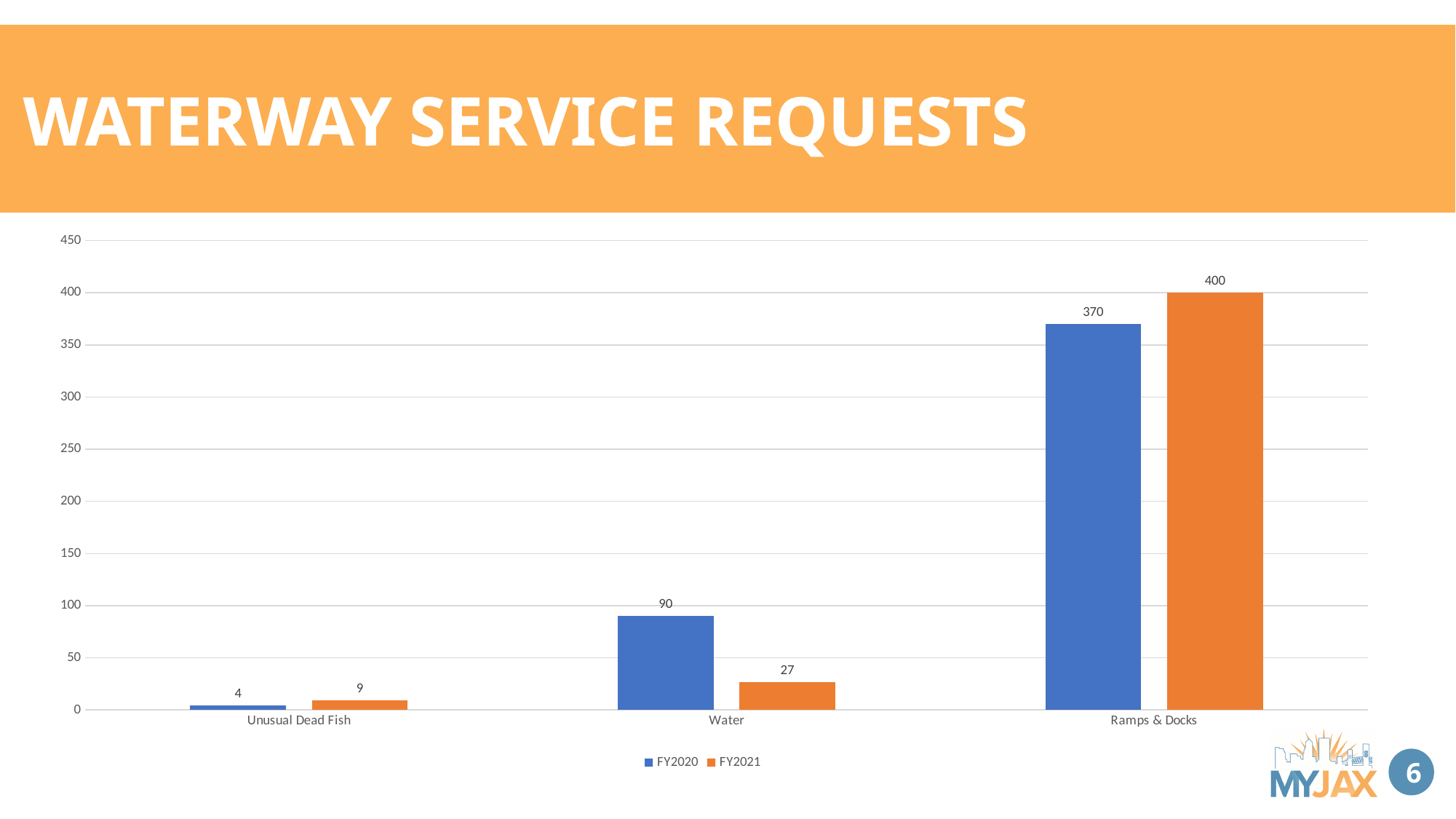
What kind of chart is shown on the slide? Bar chart How many categories are shown on the x axis? 3 Which category has the lowest FY2021 value? Unusual Dead Fish What is the FY2021 value for Ramps & Docks? 400 Which is larger for Water, the FY2020 value or the FY2021 value? FY2020 What is the difference between the FY2020 and FY2021 values for Water? 63 What is the difference between the FY2021 and FY2020 values for Ramps & Docks? 30 What is the FY2020 value for Water? 90 What is the FY2021 value for Unusual Dead Fish? 9 How many series does the legend list? 2 Which category has the highest FY2020 value? Ramps & Docks What is the title of the slide? WATERWAY SERVICE REQUESTS